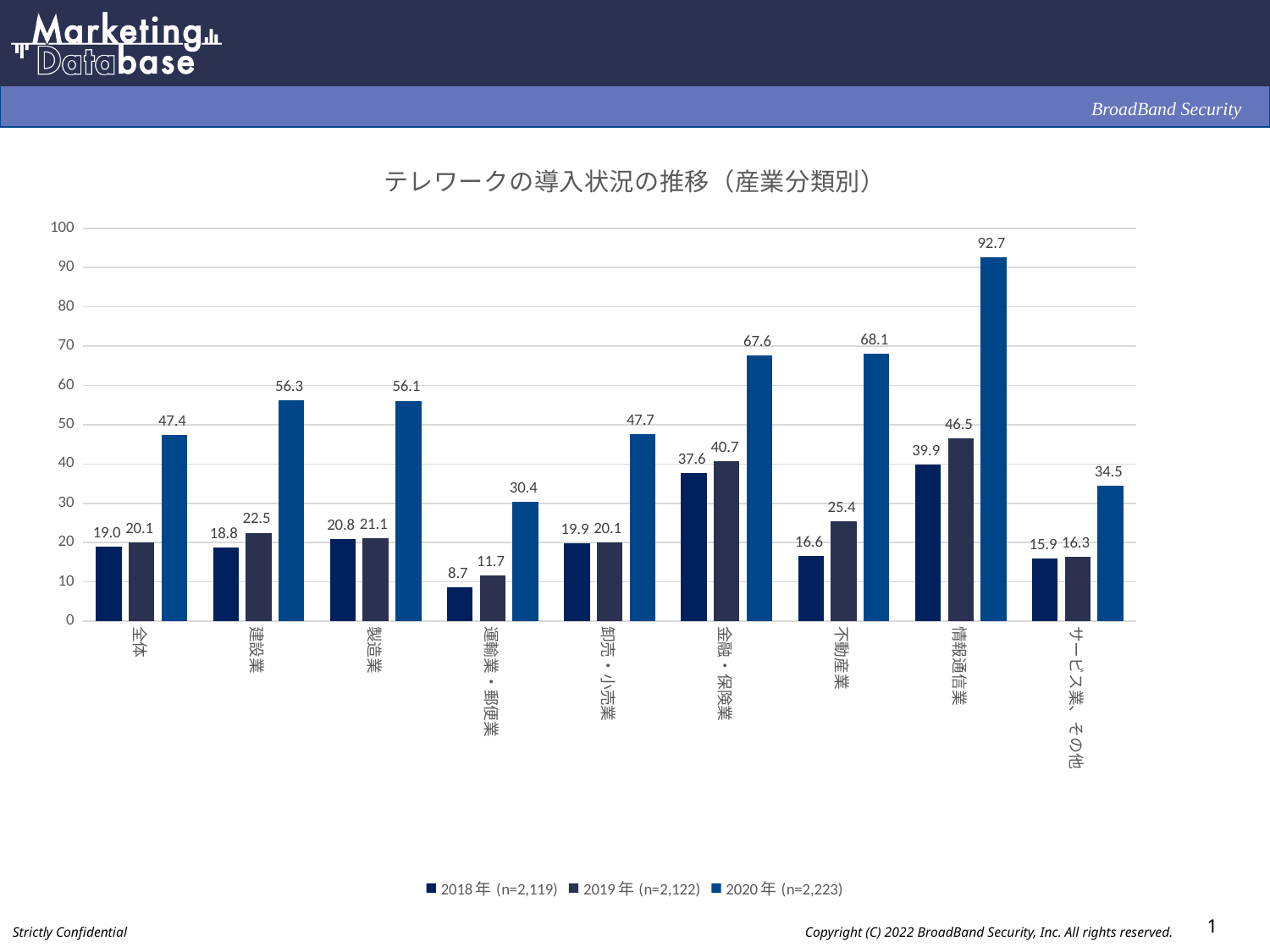
What is the difference between the 2020年 and 2018年 values for 全体? 28.4 For 建設業, do the values rise or fall from 2018年 to 2020年? Rise What is the 2019年 value for 不動産業? 25.4 Which category has the lowest 2019年 value? 運輸業・郵便業 Which category has the highest 2020年 value? 情報通信業 What is the 2018年 value for 運輸業・郵便業? 8.7 What kind of chart is shown on the slide? Bar chart What is the 2020年 value for 情報通信業? 92.7 What is the title of the chart? テレワークの導入状況の推移（産業分類別） Which is larger, the 2020年 value for 金融・保険業 or the 2020年 value for 不動産業? 不動産業 How many industry categories are shown on the x axis? 9 How many series does the legend list? 3